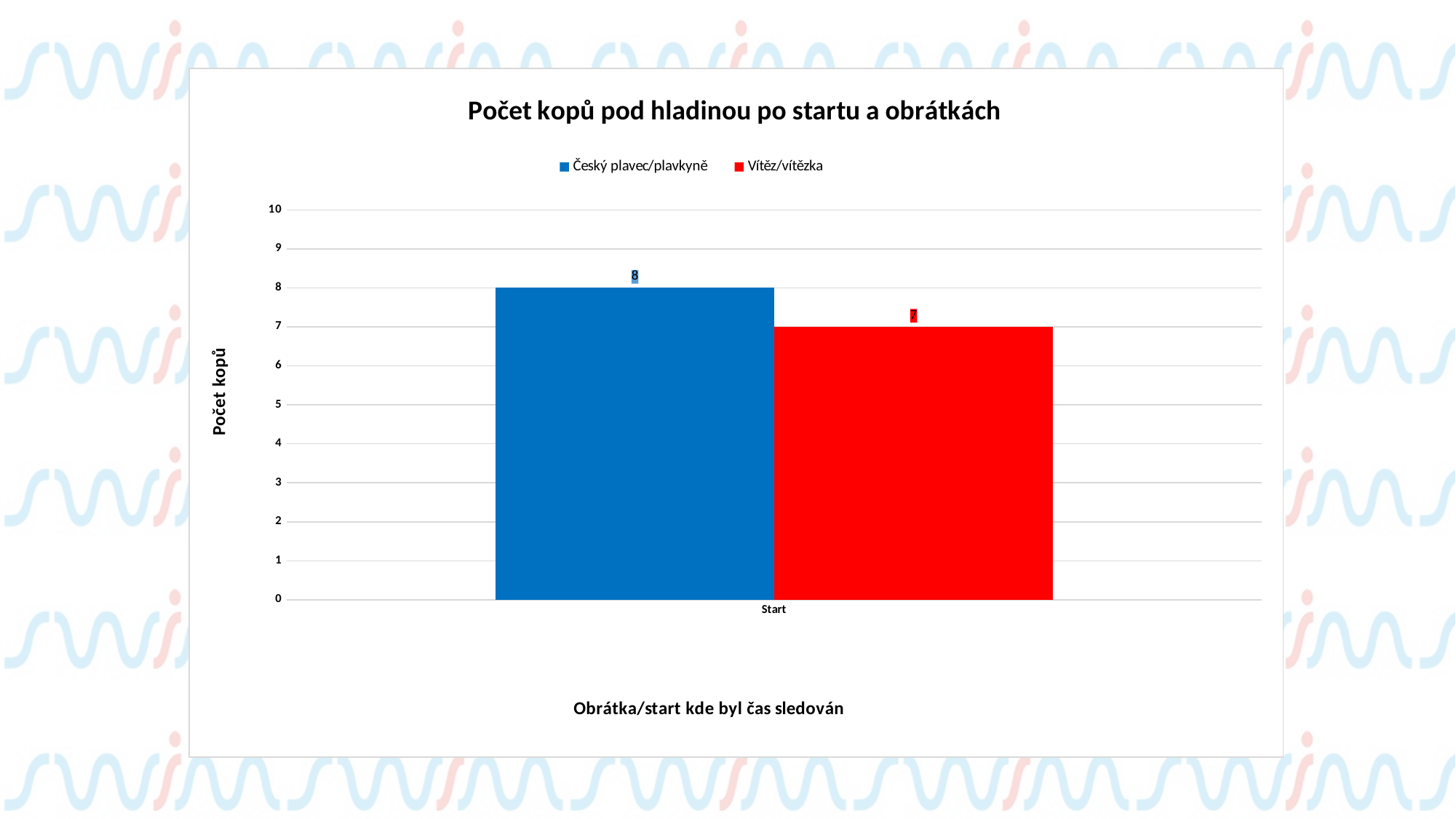
Is the value for Český plavec/plavkyně at Start greater or less than 9? less How many series does the legend list? 2 What kind of chart is shown? bar chart What is the difference between the Český plavec/plavkyně and Vítěz/vítězka values at Start? 1 Is the value for Vítěz/vítězka at Start greater or less than 5? greater What is the title of the chart? Počet kopů pod hladinou po startu a obrátkách Which series has the higher value at Start? Český plavec/plavkyně What colour is the bar for Vítěz/vítězka? red How many categories are shown on the x axis? 1 Which series has the lowest value at Start? Vítěz/vítězka What is the value for Český plavec/plavkyně at Start? 8 What is the value for Vítěz/vítězka at Start? 7